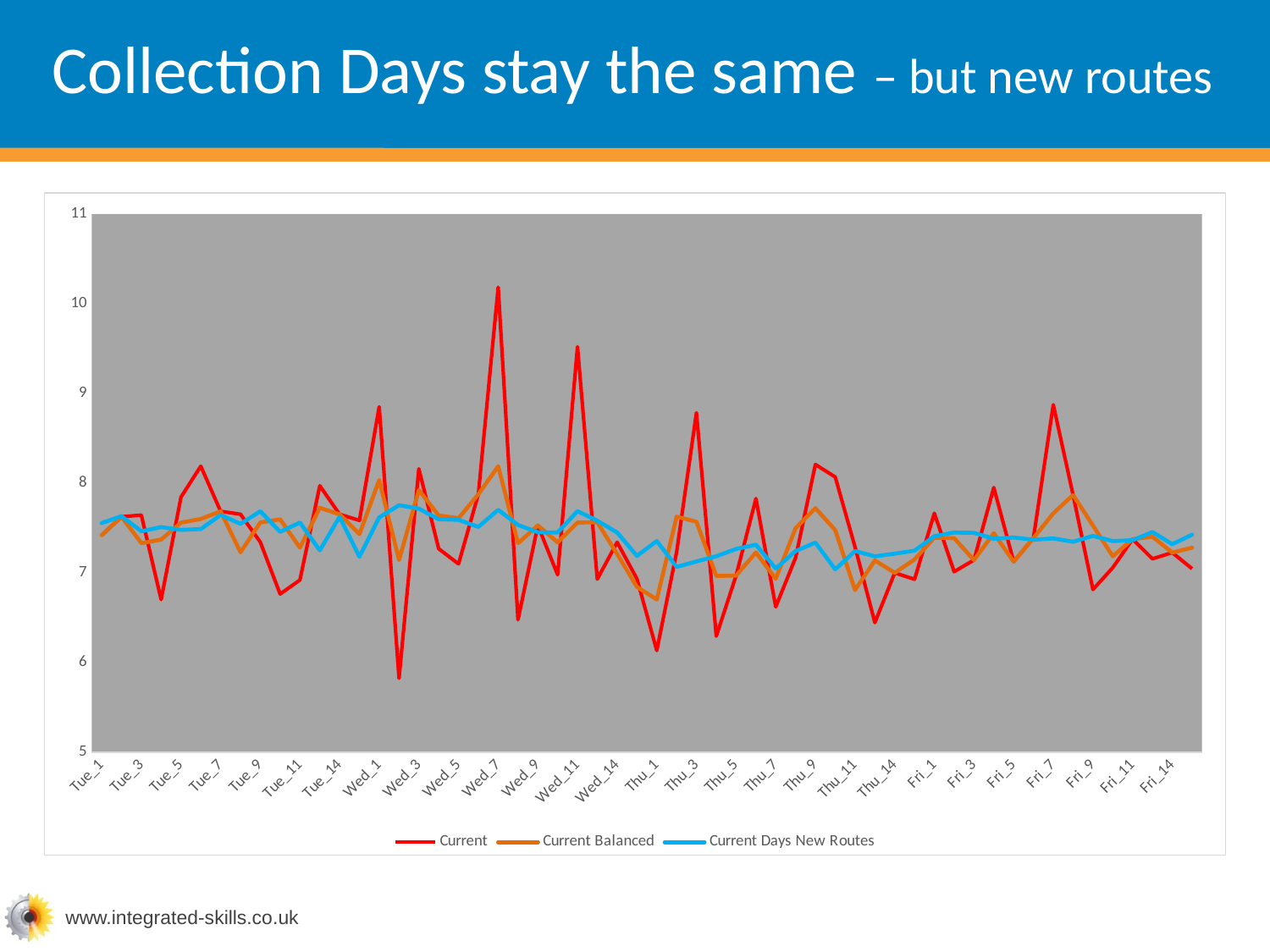
Is the value of the Current series at Thu_1 greater or less than 7? less Is the value of the Current series at Fri_7 greater or less than 8? greater What are the three series named in the legend? Current, Current Balanced, Current Days New Routes What kind of chart is shown on the slide? line chart Is the value of the Current series at Wed_11 greater or less than 9? greater How many series does the legend list? 3 Which is larger for the Current series: the value at Wed_7 or the value at Wed_11? Wed_7 At which x-axis label does the Current series reach its highest value? Wed_7 What is the highest value shown on the y axis? 11